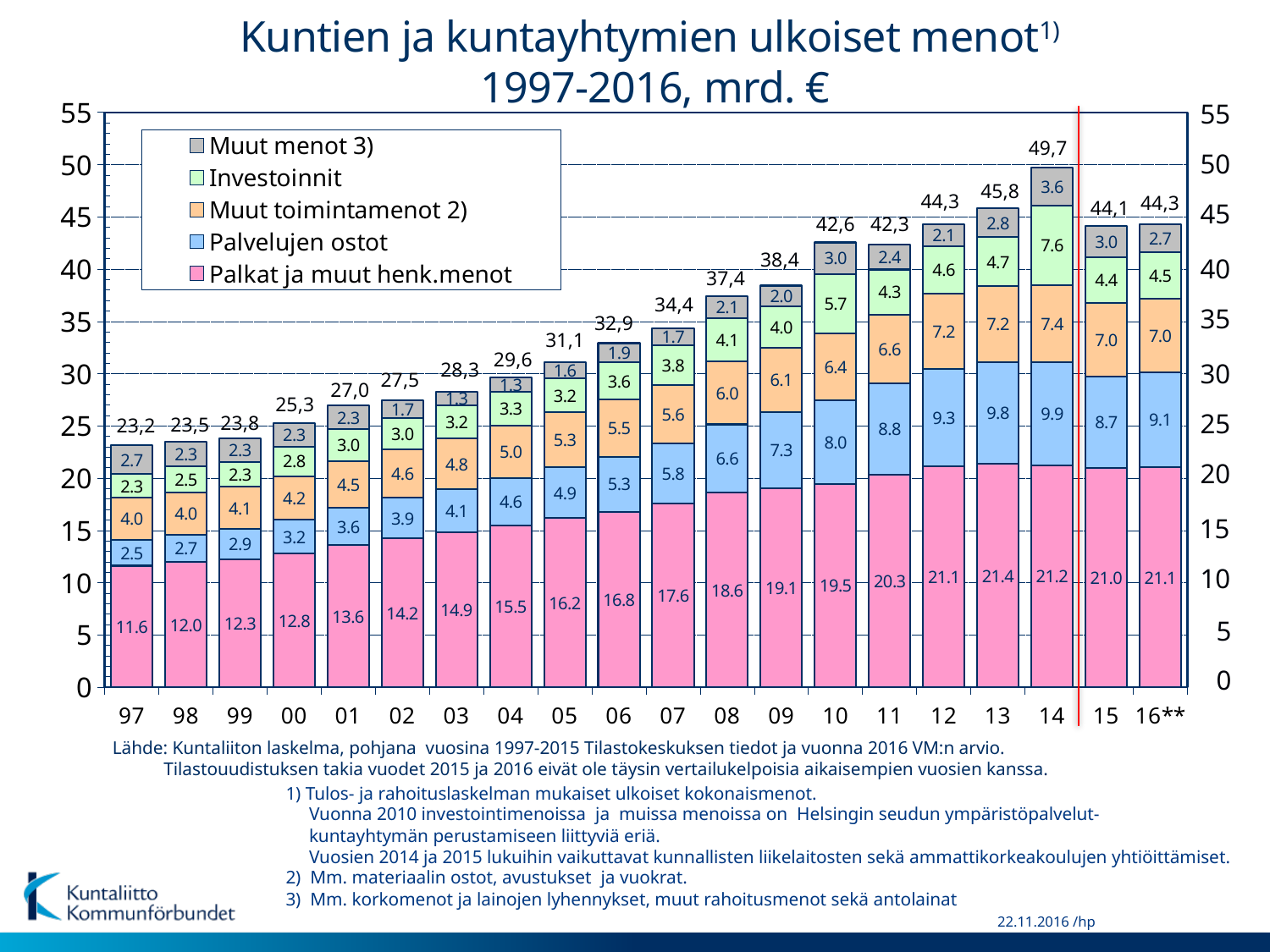
What is the difference between the total for 2014 (14) and the total for 2015 (15)? 5,6 Which year has the lowest total external expenditure? 97 What type of chart is shown on the slide? Stacked bar chart What is the value of Palvelujen ostot for 2013 (13)? 9.8 Do the total values generally rise or fall from 1997 to 2014? Rise What is the value of Investoinnit for 2010 (10)? 5.7 What is the total value printed above the bar for 2014 (14)? 49,7 Which year has the highest total external expenditure? 14 What is the value of Palkat ja muut henk.menot for 1997 (97)? 11.6 How many years (bars) are shown on the x axis? 20 Is the Muut toimintamenot value larger in 2012 (12) or in 2008 (08)? 2012 (12) How many series does the legend list? 5